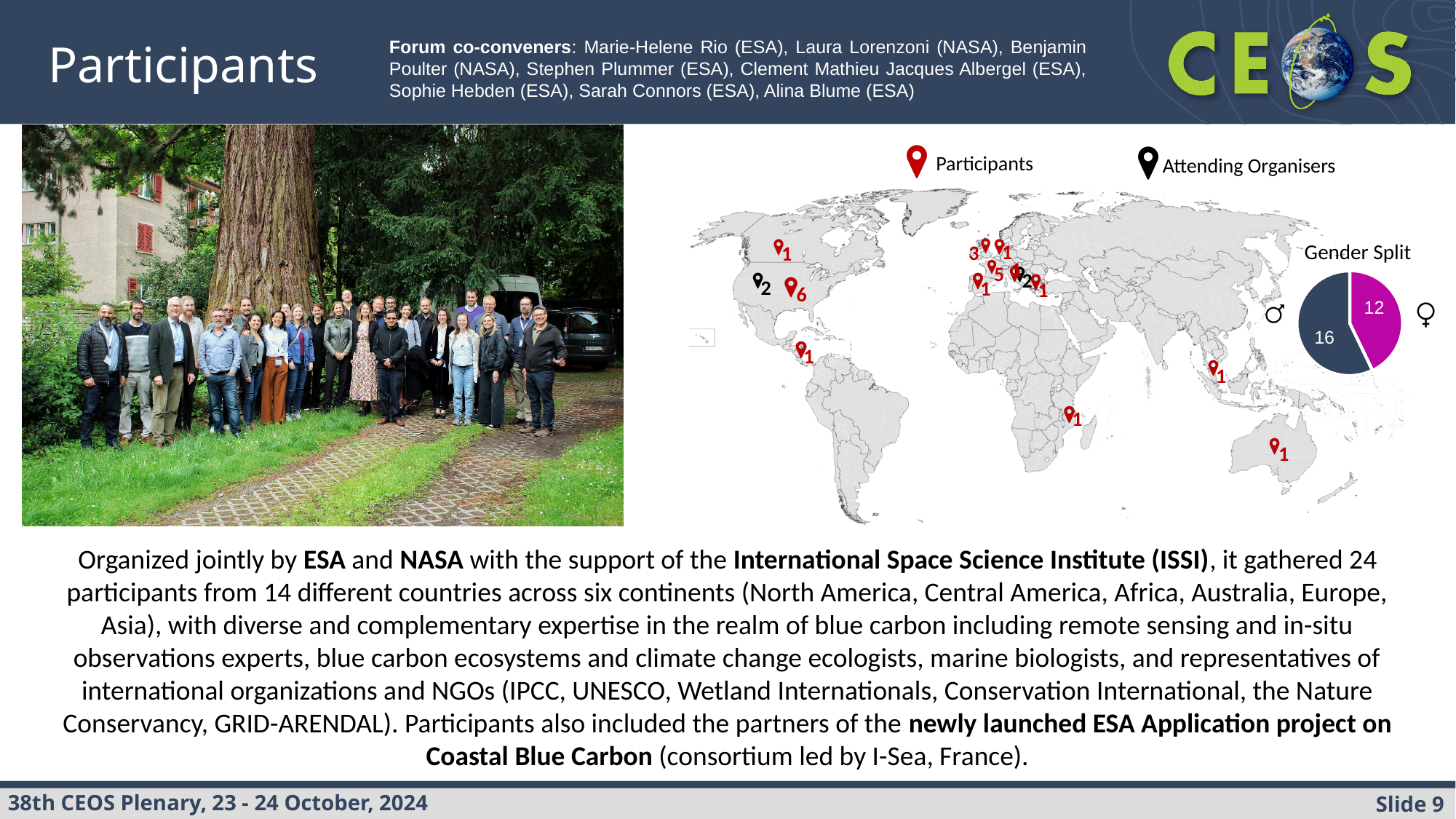
In the Gender Split pie chart, what is the difference between the male and female values? 4 In the Gender Split pie chart, what is the value for the female slice? 12 In the Gender Split pie chart, which slice is larger, male or female? male On the world map, what is the largest number shown on a Participants pin? 6 What is the total of the two values shown in the Gender Split pie chart? 28 What kind of chart is the Gender Split chart? pie chart What is the title of the pie chart on the slide? Gender Split On the world map, how many Attending Organisers are marked by the pin in the United States? 2 How many slices does the Gender Split pie chart have? 2 In the Gender Split pie chart, what colour is the female slice? magenta In the Gender Split pie chart, what is the value for the male slice? 16 In the Gender Split pie chart, which gender has the smallest slice? female